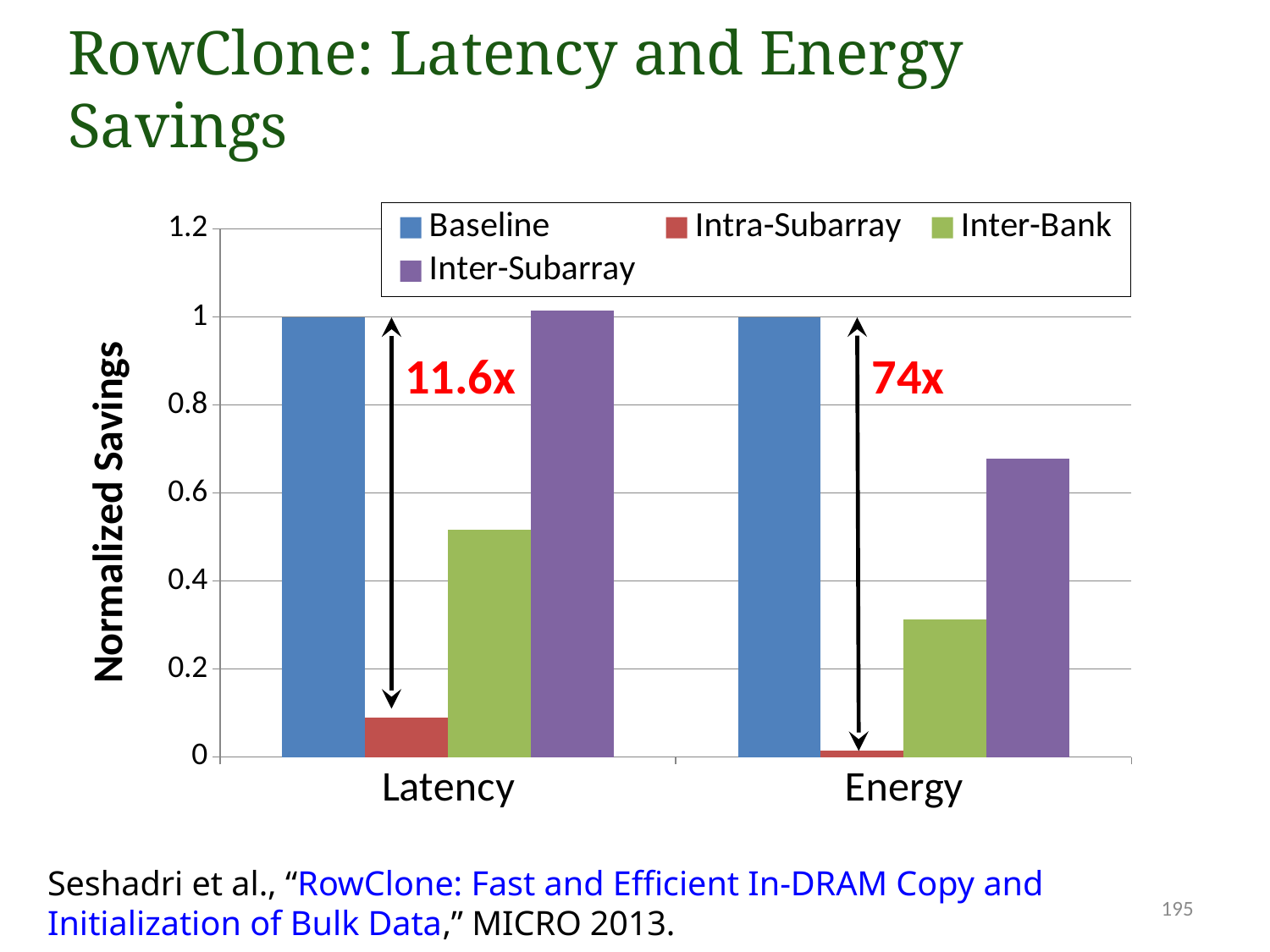
Is the Intra-Subarray value for Latency greater or less than 0.2? less How many categories are shown on the x axis of the chart? 2 What is the Baseline value for Energy? 1 Is the Inter-Bank value larger for Latency or for Energy? Latency Is the Inter-Bank value for Energy greater or less than 0.4? less Which series has the lowest value for Energy? Intra-Subarray What improvement factor is annotated above the Energy bars? 74x Is the Inter-Bank value for Latency greater or less than 0.4? greater How many series does the chart's legend list? 4 What kind of chart is shown on the slide? bar chart What is the Baseline value for Latency? 1